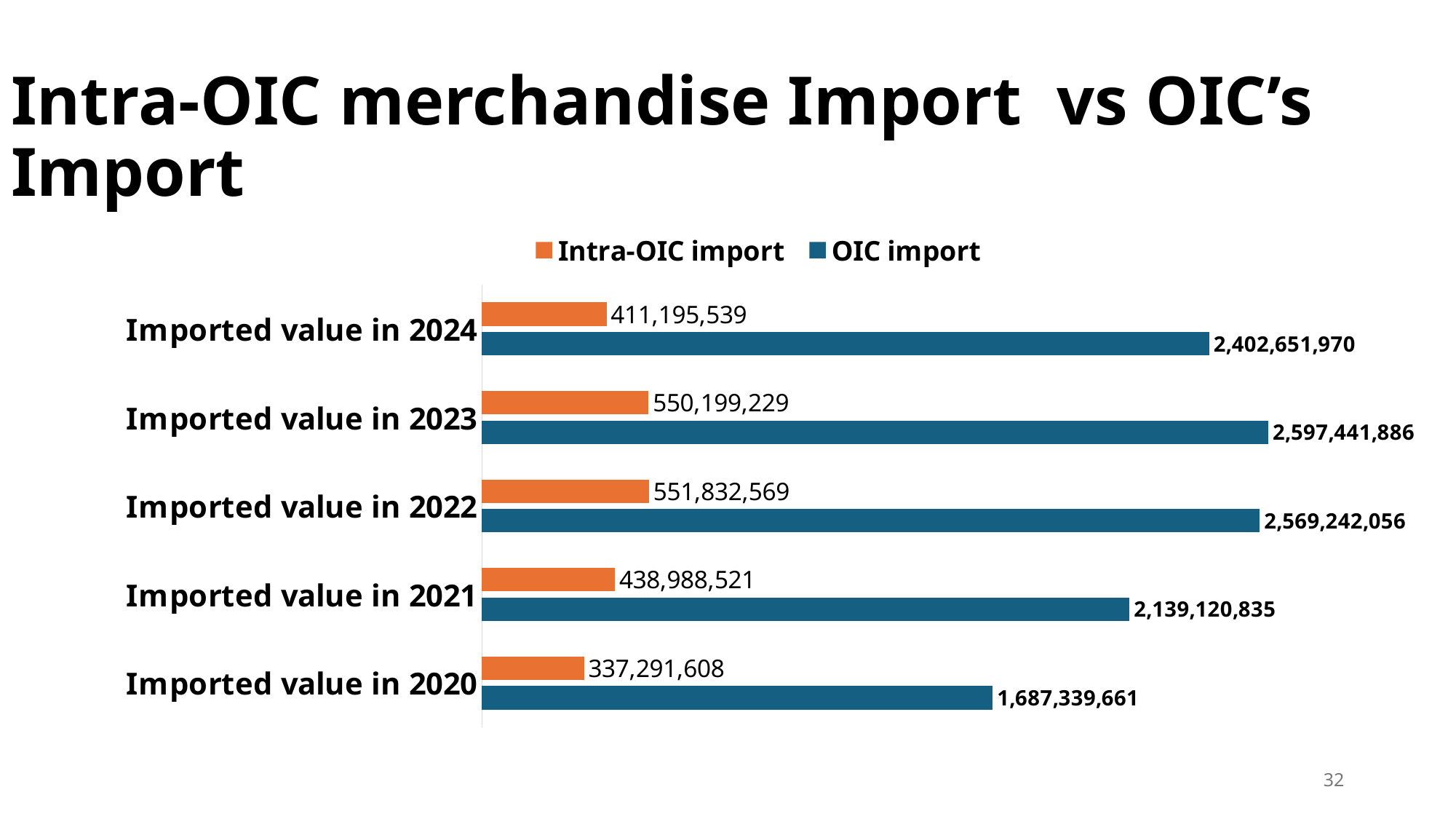
Which year has the highest OIC import value? Imported value in 2023 How many series does the legend list? 2 What is the difference between the OIC import values for 2023 and 2020? 910,102,225 Which year has the lowest Intra-OIC import value? Imported value in 2020 What is the OIC import value for Imported value in 2023? 2,597,441,886 What kind of chart is shown on the slide? Bar chart What is the Intra-OIC import value for Imported value in 2021? 438,988,521 What is the OIC import value for Imported value in 2020? 1,687,339,661 What is the Intra-OIC import value for Imported value in 2024? 411,195,539 How many year categories are shown on the chart? 5 What is the difference between the OIC import and the Intra-OIC import for Imported value in 2024? 1,991,456,431 Which is larger: the Intra-OIC import in 2023 or the Intra-OIC import in 2021? Intra-OIC import in 2023